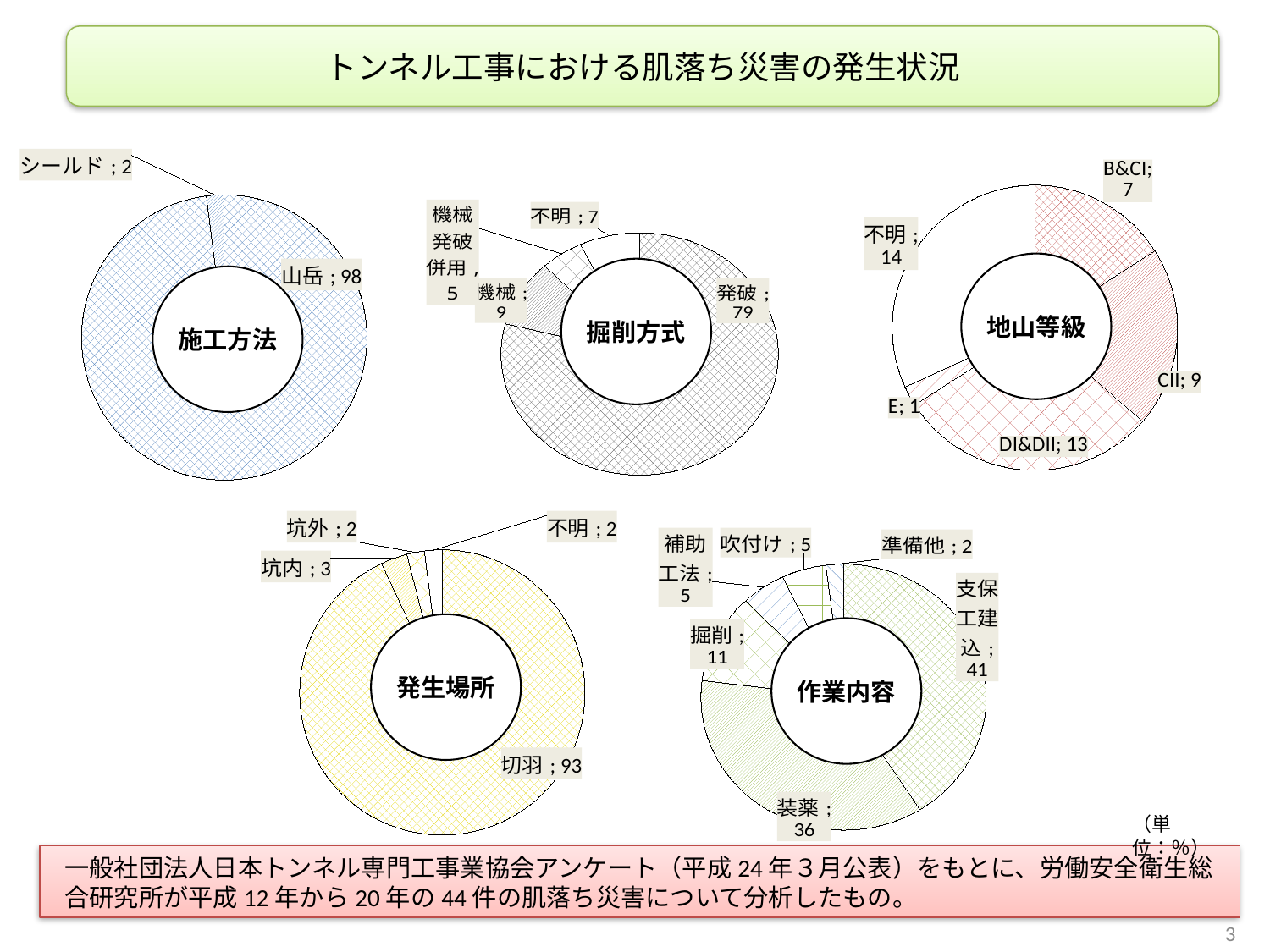
In the 掘削方式 chart, what is the difference between 発破 and 不明? 72 In the 作業内容 chart, what is the difference between 支保工建込 and 装薬? 5 In the 掘削方式 chart, which category has the largest value? 発破 In the 地山等級 chart, how many categories are shown? 5 In the 地山等級 chart, which category has the smallest value? E In the 施工方法 chart, what is the value for シールド? 2 In the 施工方法 chart, what is the value for 山岳? 98 In the 地山等級 chart, what is the value for DI&DII? 13 In the 発生場所 chart, what is the value for 切羽? 93 In the 発生場所 chart, which is larger, 坑内 or 坑外? 坑内 What kind of chart is the 作業内容 chart? Doughnut chart In the 掘削方式 chart, what is the value for 機械? 9